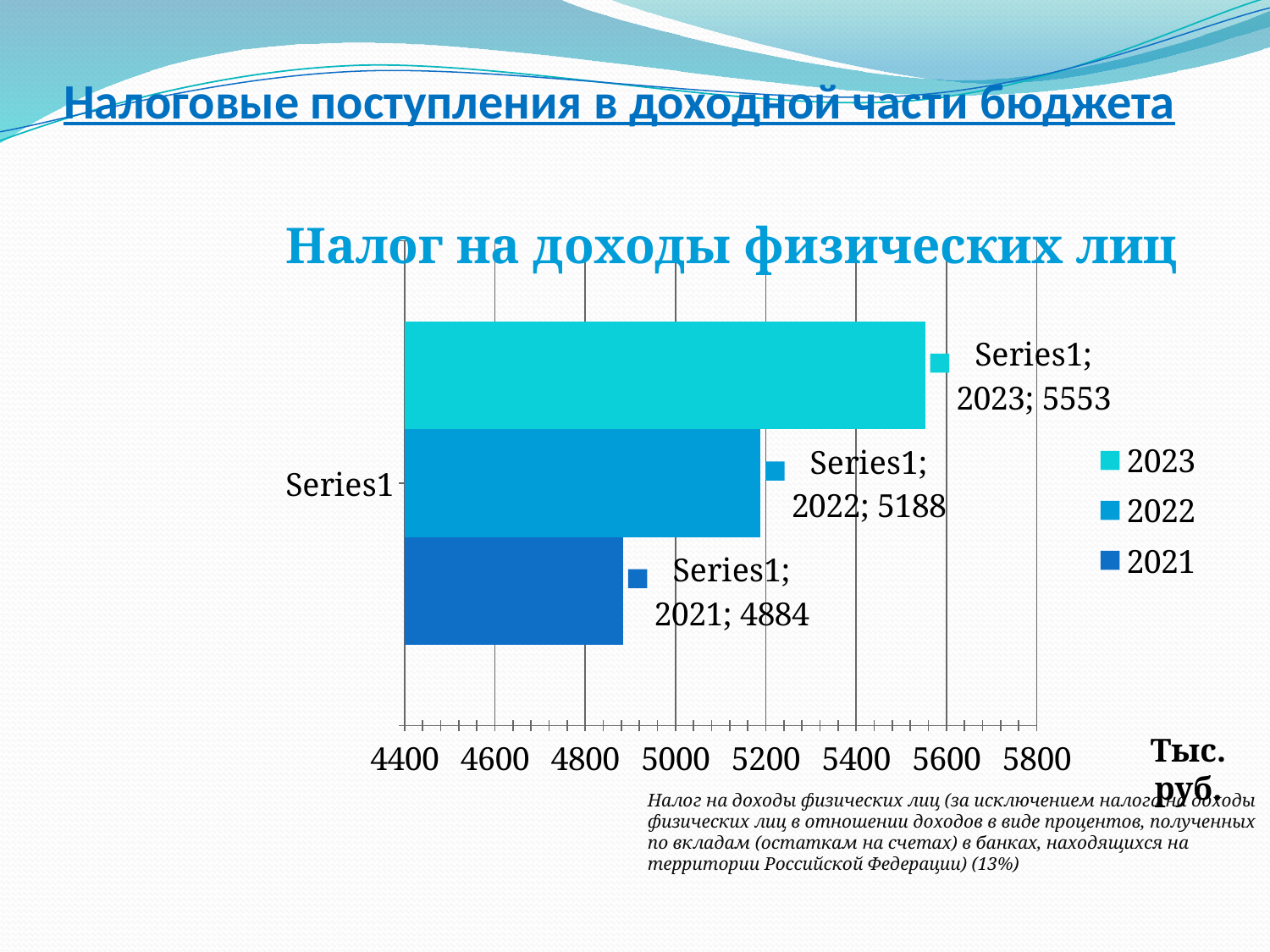
Is the value for 2021 greater or less than 5000? less What is the value for 2021 in the chart? 4884 What is the value for 2023 in the chart? 5553 What is the value for 2022 in the chart? 5188 What type of chart is shown on the slide? bar chart How many bars are plotted in the chart? 3 What is the difference between the values for 2022 and 2021? 304 What is the title of the chart? Налог на доходы физических лиц Which year has the highest value in the chart? 2023 Which year has the lowest value in the chart? 2021 Which is larger, the value for 2022 or the value for 2021? 2022 What is the difference between the values for 2023 and 2022? 365